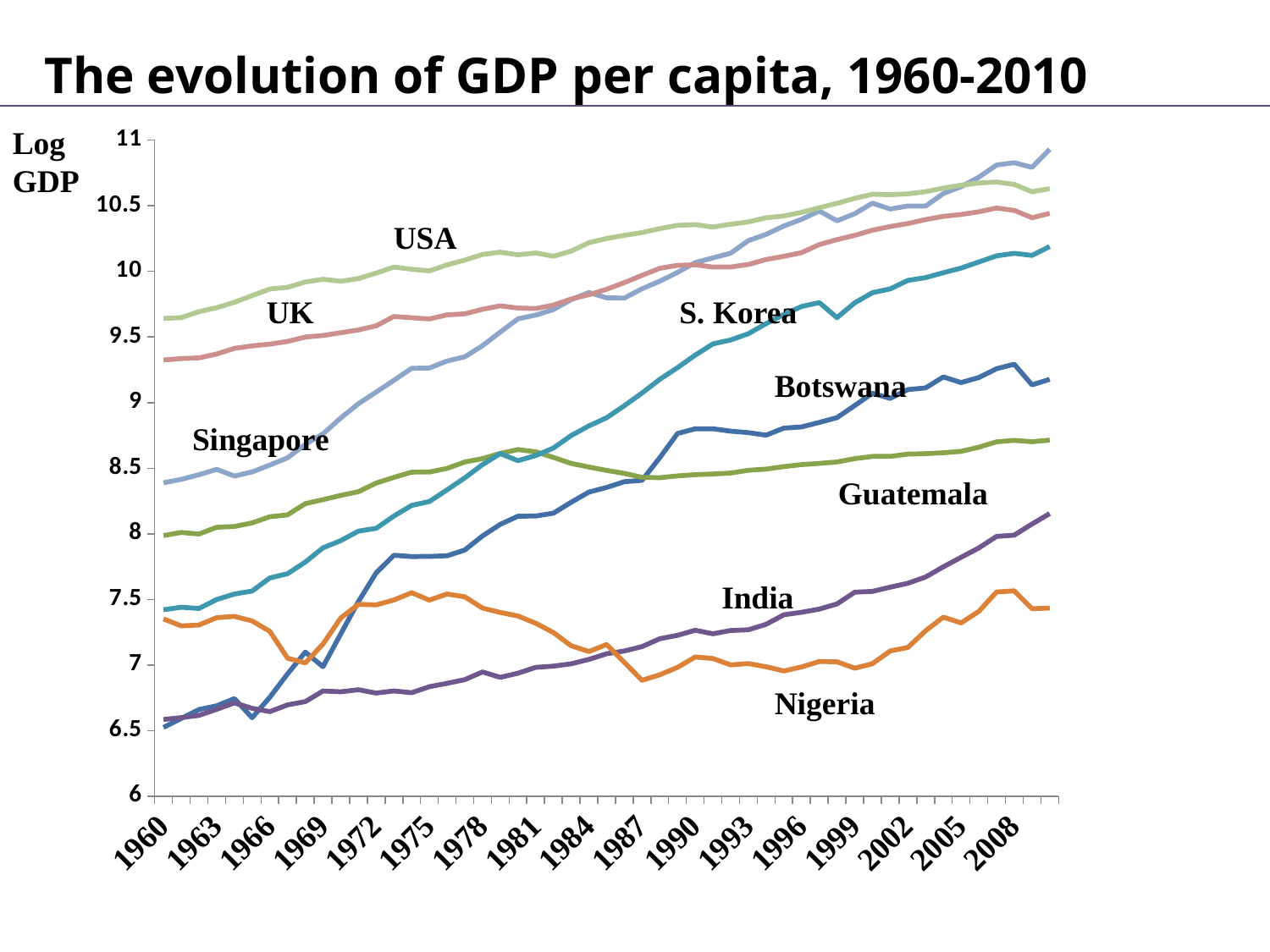
How many countries are plotted on the chart? 8 Is the value for S. Korea in 1960 greater or less than 8? less What is the title of the chart? The evolution of GDP per capita, 1960-2010 Which country has the highest log GDP per capita in 1960? USA Which country has the highest log GDP per capita in 2010? Singapore Is the value for Guatemala in 2010 greater or less than 8.5? greater Is the value for USA in 1960 greater or less than 9.5? greater What is the label on the vertical axis? Log GDP In 2010, which is higher, the value for Singapore or the value for USA? Singapore Does the value for S. Korea rise or fall from 1960 to 2010? rise What kind of chart is shown on the slide? line chart Which country has the lowest log GDP per capita in 2010? Nigeria